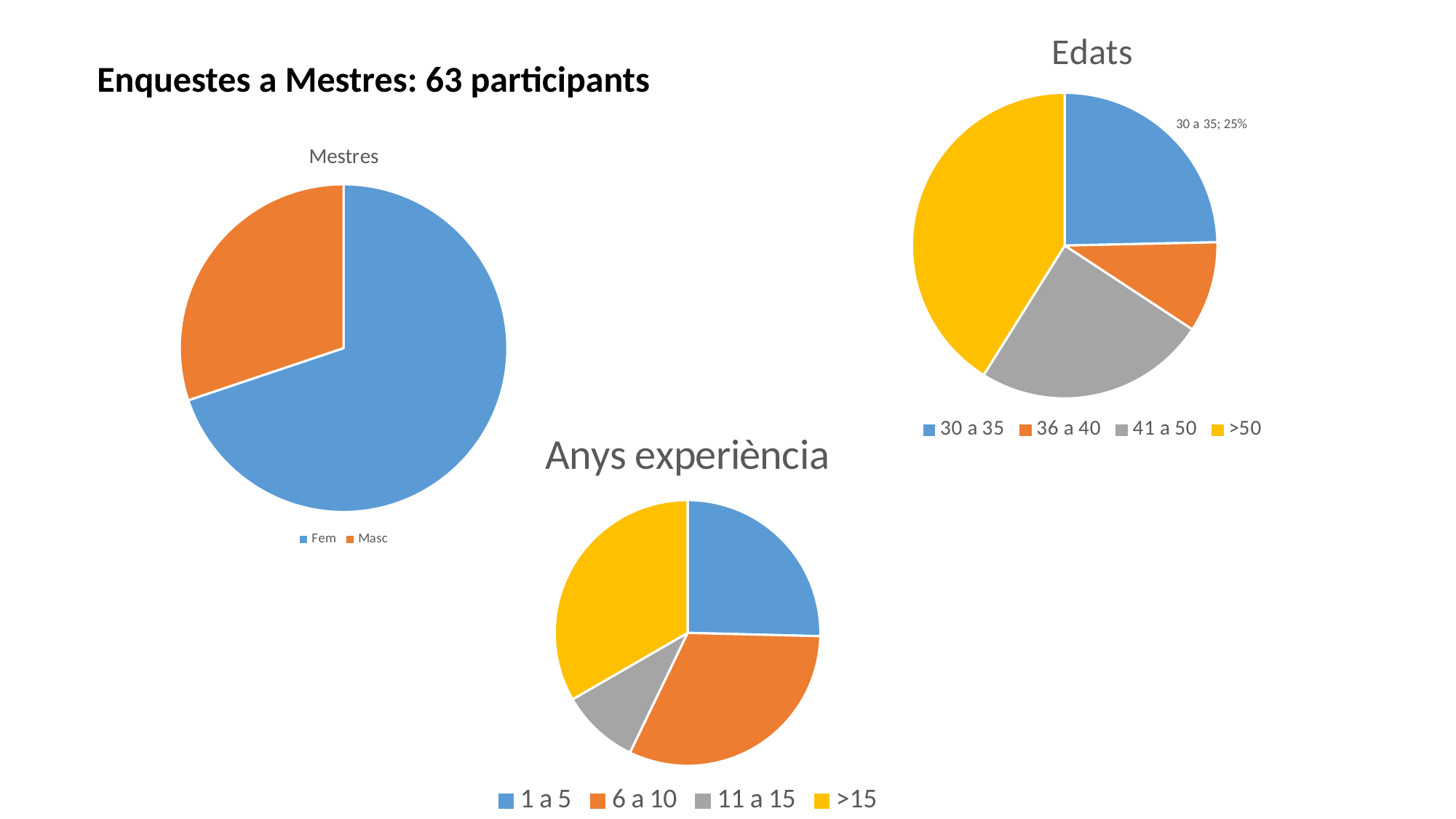
In the 'Mestres' chart, which category has the largest slice? Fem How many categories does the legend of the 'Mestres' chart list? 2 In the 'Mestres' chart, which category has the smallest slice? Masc In the 'Anys experiència' chart, which category has the largest slice? >15 In the 'Edats' chart, what share of the pie is the '30 a 35' slice? 25% In the 'Anys experiència' chart, which category has the smallest slice? 11 a 15 In the 'Edats' chart, which colour represents the '41 a 50' category? grey In the 'Edats' chart, which category has the smallest slice? 36 a 40 What kind of chart is the 'Mestres' chart? pie chart How many categories does the legend of the 'Edats' chart list? 4 In the 'Edats' chart, which category has the largest slice? >50 In the 'Anys experiència' chart, which slice is larger: '1 a 5' or '11 a 15'? 1 a 5